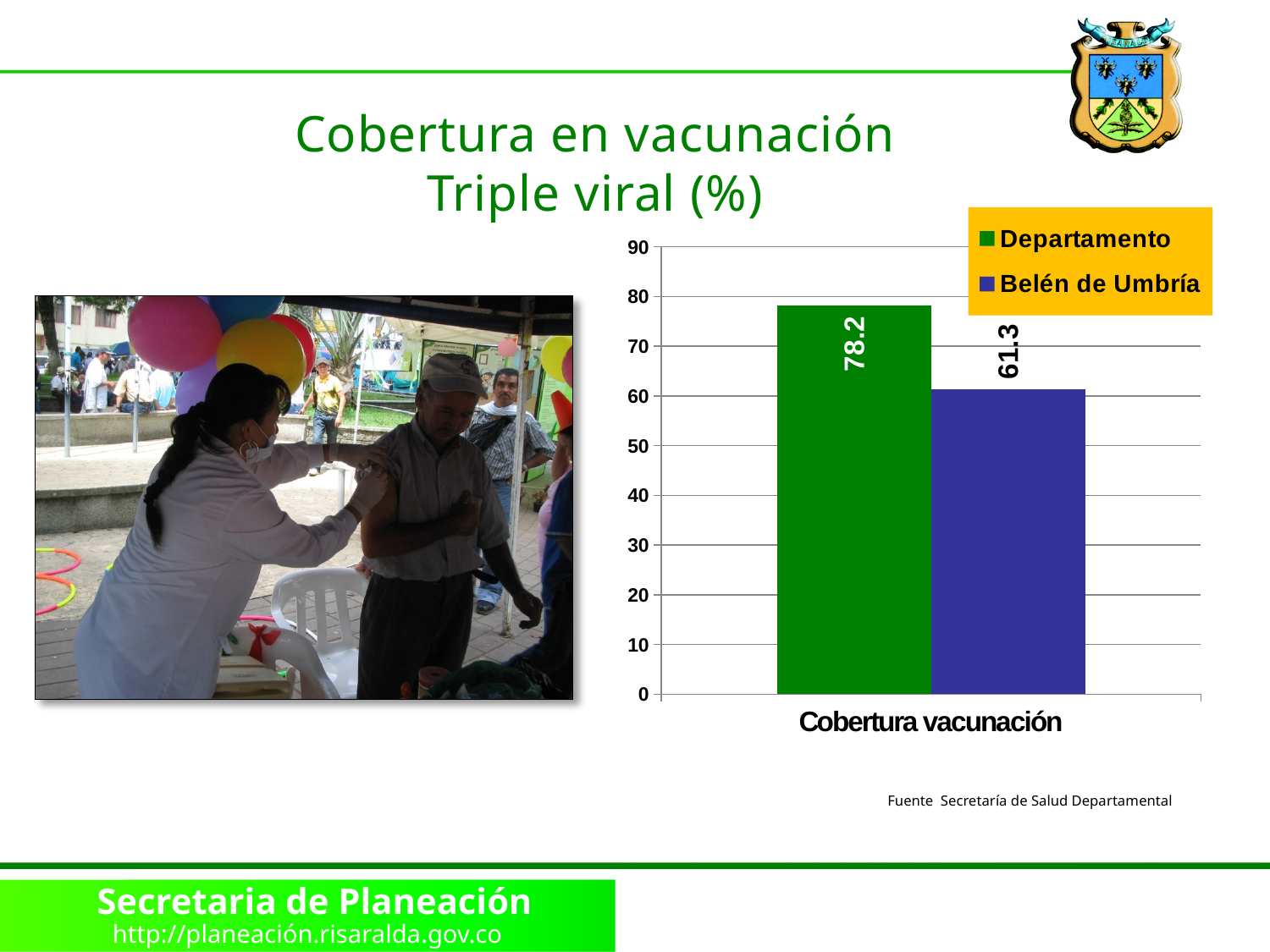
Is the value for Belén de Umbría greater or less than 70? less What is the difference between the Departamento value and the Belén de Umbría value? 16.9 Which series has the higher value, Departamento or Belén de Umbría? Departamento What is the highest value shown on the y axis of the chart? 90 What kind of chart is shown on the slide? bar chart What is the value for Belén de Umbría in the chart? 61.3 What is the category label shown on the x axis of the chart? Cobertura vacunación Which series has the lowest value in the chart? Belén de Umbría What is the value for Departamento in the chart? 78.2 How many series does the legend list? 2 What colour is the bar for Departamento? green Is the value for Departamento greater or less than 70? greater